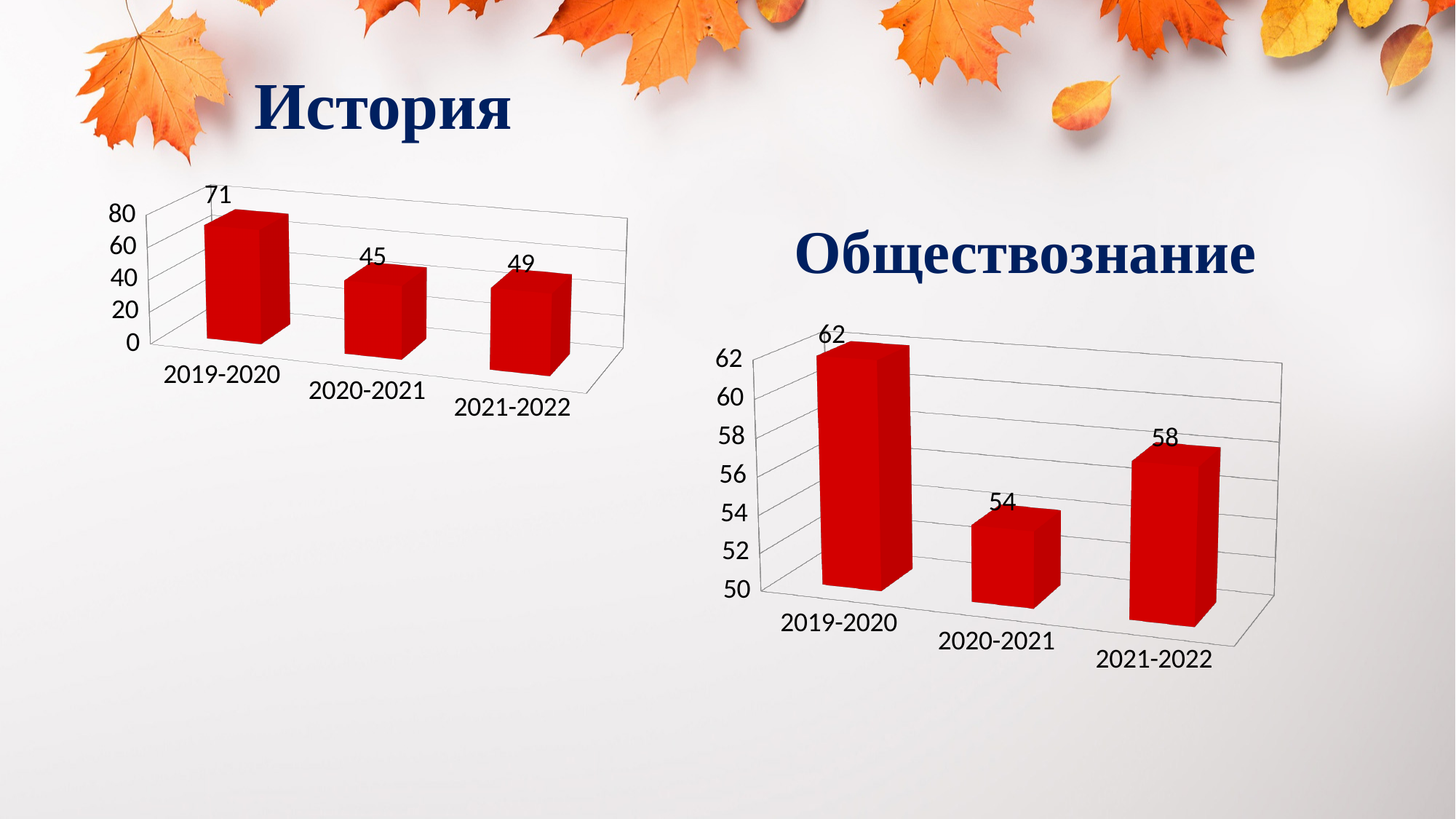
What kind of chart is the История chart? bar chart In the История chart, what is the difference between the values for 2019-2020 and 2021-2022? 22 In the Обществознание chart, which year has the highest value? 2019-2020 In the История chart, how many categories are shown on the x axis? 3 In the Обществознание chart, which is larger: the value for 2020-2021 or the value for 2021-2022? 2021-2022 In the Обществознание chart, what is the value for 2021-2022? 58 In the Обществознание chart, what is the difference between the values for 2019-2020 and 2020-2021? 8 In the Обществознание chart, what is the value for 2020-2021? 54 In the История chart, what is the value for 2019-2020? 71 In the История chart, what is the value for 2020-2021? 45 In the История chart, which year has the lowest value? 2020-2021 What colour are the bars in the Обществознание chart? red